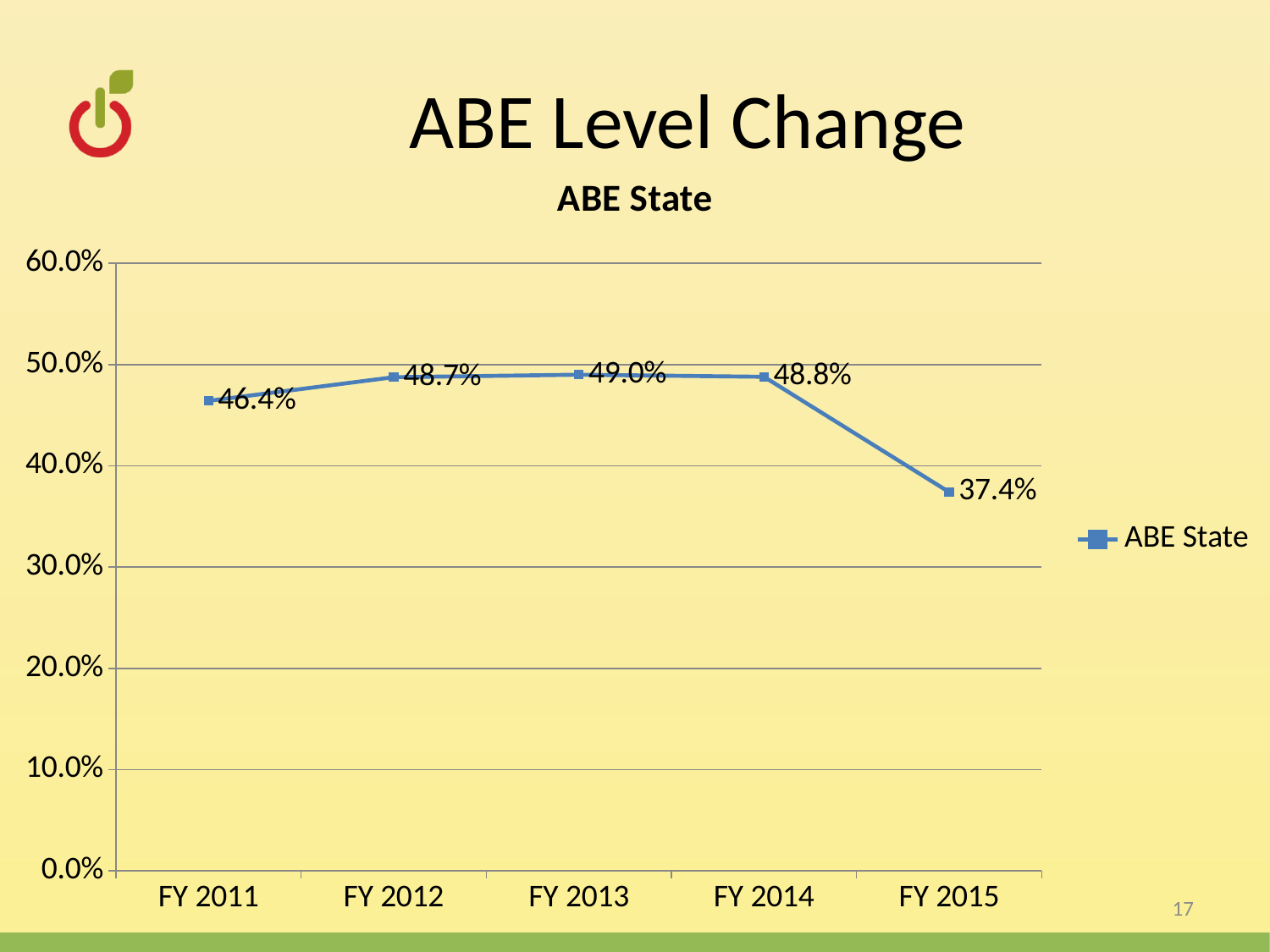
How many fiscal years are plotted on the chart? 5 What is the title of the chart? ABE State Which fiscal year has the lowest ABE State value? FY 2015 Which fiscal year has the highest ABE State value? FY 2013 What is the ABE State value for FY 2015? 37.4% What kind of chart is shown on the slide? line chart Is the value for FY 2015 greater or less than 40.0%? less What is the difference between the FY 2014 and FY 2015 values? 11.4% What is the ABE State value for FY 2011? 46.4% How many series does the legend list? 1 What is the ABE State value for FY 2013? 49.0% Which is larger, the value for FY 2011 or the value for FY 2012? FY 2012